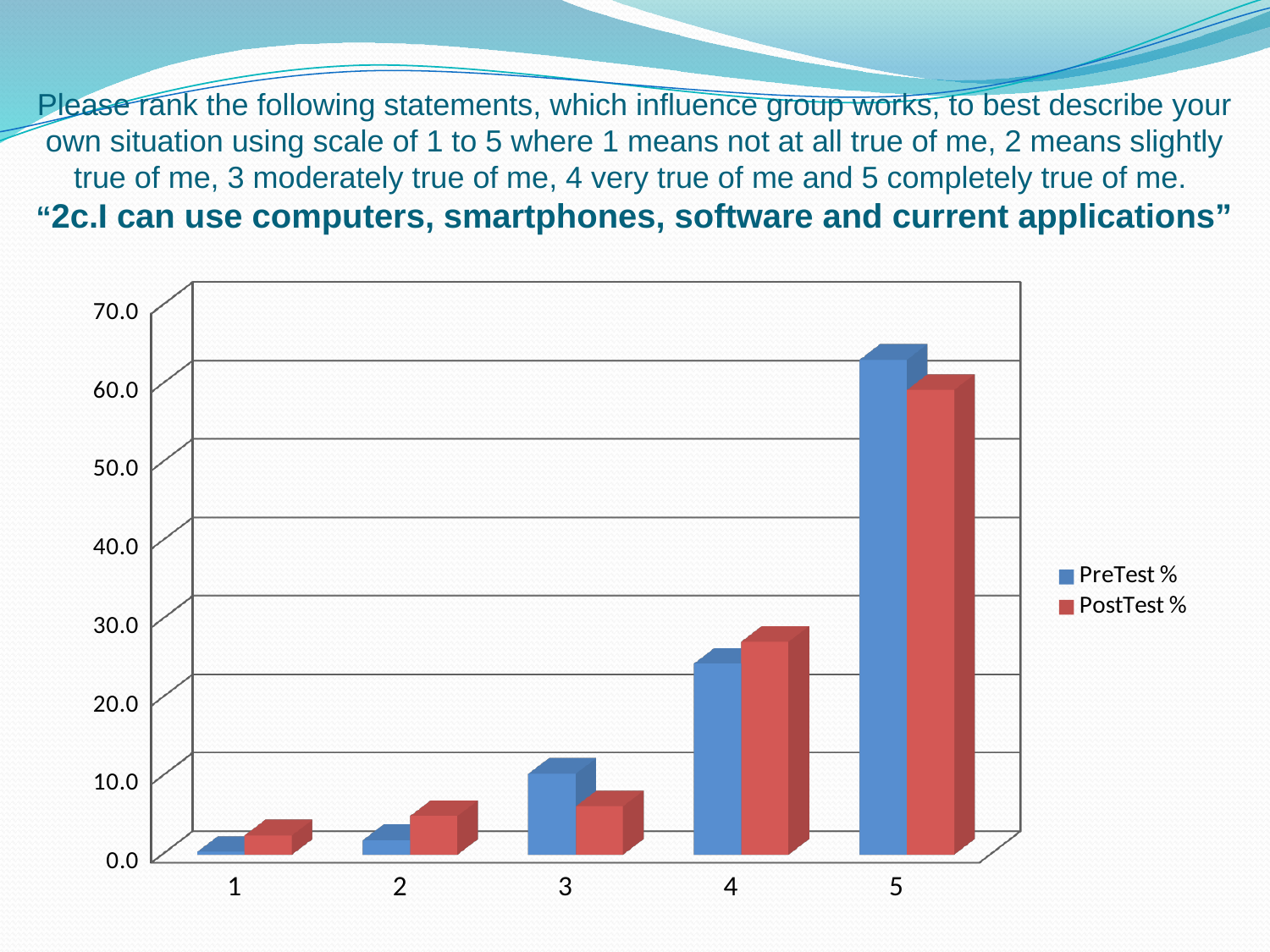
How many categories are shown on the x axis? 5 For category 5, which series has the larger value, PreTest % or PostTest %? PreTest % Which category has the highest PreTest % value? 5 Which category has the highest PostTest % value? 5 Is the PostTest % value for category 3 greater or less than 10.0? less What are the two series named in the legend? PreTest % and PostTest % What kind of chart is shown on the slide? bar chart For category 4, which series has the larger value, PreTest % or PostTest %? PostTest % Is the PreTest % value for category 5 greater or less than 60.0? greater Do the PreTest % values rise or fall as the scale goes from 1 to 5? rise How many series does the legend list? 2 Which category has the lowest PreTest % value? 1